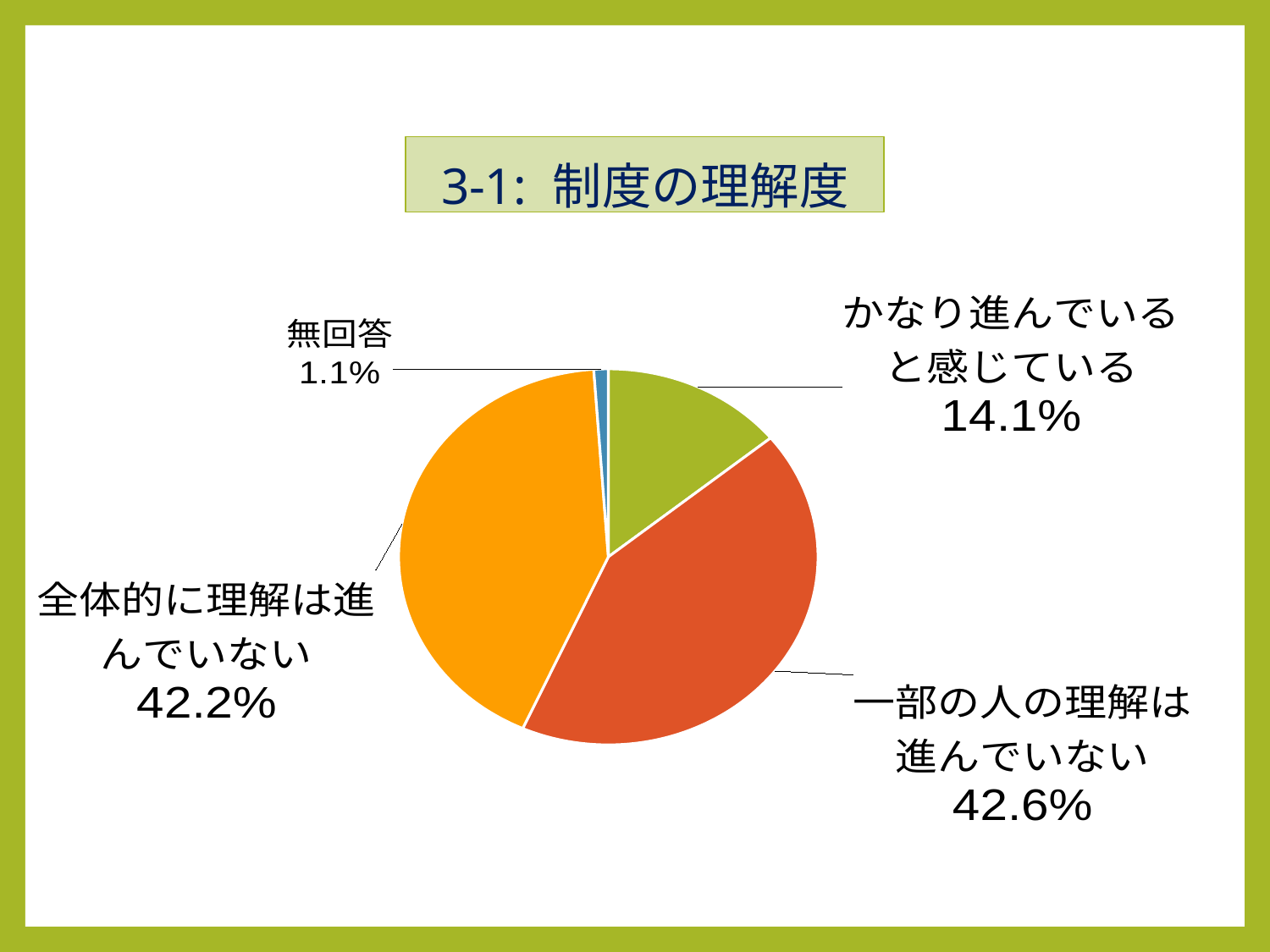
What is the title of the chart? 3-1: 制度の理解度 What percentage of the pie is 「無回答」? 1.1% Which category has the smallest share of the pie? 無回答 What is the difference in percentage points between 「一部の人の理解は進んでいない」 and 「かなり進んでいると感じている」? 28.5 Which is larger, the share for 「かなり進んでいると感じている」 or the share for 「一部の人の理解は進んでいない」? 一部の人の理解は進んでいない Which category has the largest share of the pie? 一部の人の理解は進んでいない What colour is the slice for 「全体的に理解は進んでいない」? orange What percentage of the pie is 「全体的に理解は進んでいない」? 42.2% What percentage of the pie is 「かなり進んでいると感じている」? 14.1% What percentage of the pie is 「一部の人の理解は進んでいない」? 42.6% How many slices does the pie chart have? 4 What kind of chart is shown on the slide? pie chart